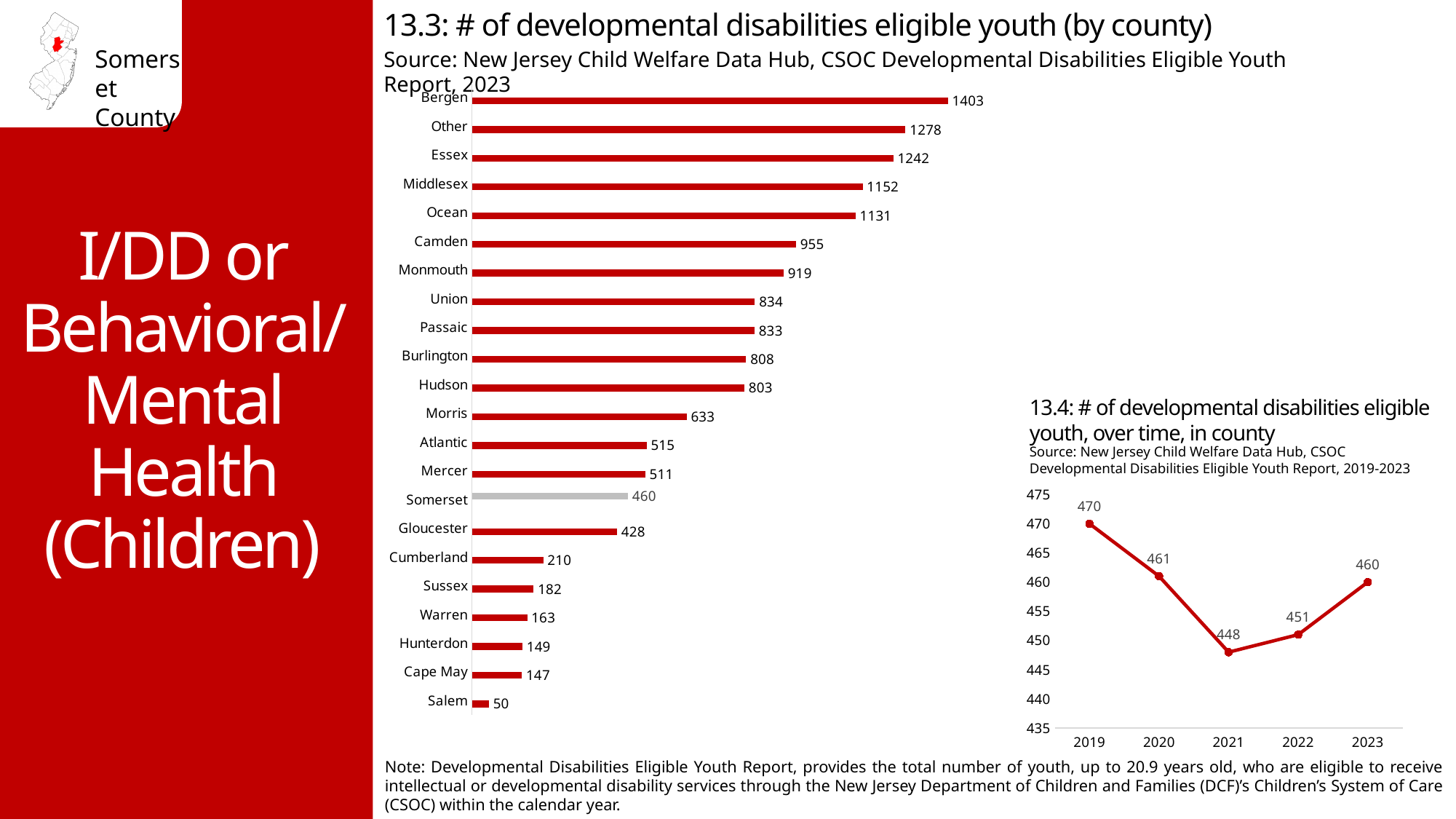
In chart 13.3 (by county), which county has the highest number of developmental disabilities eligible youth? Bergen How many counties/categories are shown in chart 13.3 (by county)? 22 In chart 13.3 (by county), which has a larger value, Camden or Monmouth? Camden In chart 13.3 (# of developmental disabilities eligible youth by county), what is the value for Somerset? 460 How many data points are plotted in chart 13.4 (over time, in county)? 5 In chart 13.4 (over time, in county), which year has the highest value? 2019 What kind of chart is chart 13.3 (# of developmental disabilities eligible youth by county)? Bar chart In chart 13.3 (by county), what is the value for Hunterdon? 149 In chart 13.3 (by county), which county has the lowest number of developmental disabilities eligible youth? Salem In chart 13.4 (over time, in county), what is the difference between the 2019 and 2023 values? 10 In chart 13.3 (by county), what is the difference between the values for Bergen and Essex? 161 In chart 13.4 (over time, in county), what is the value for 2021? 448